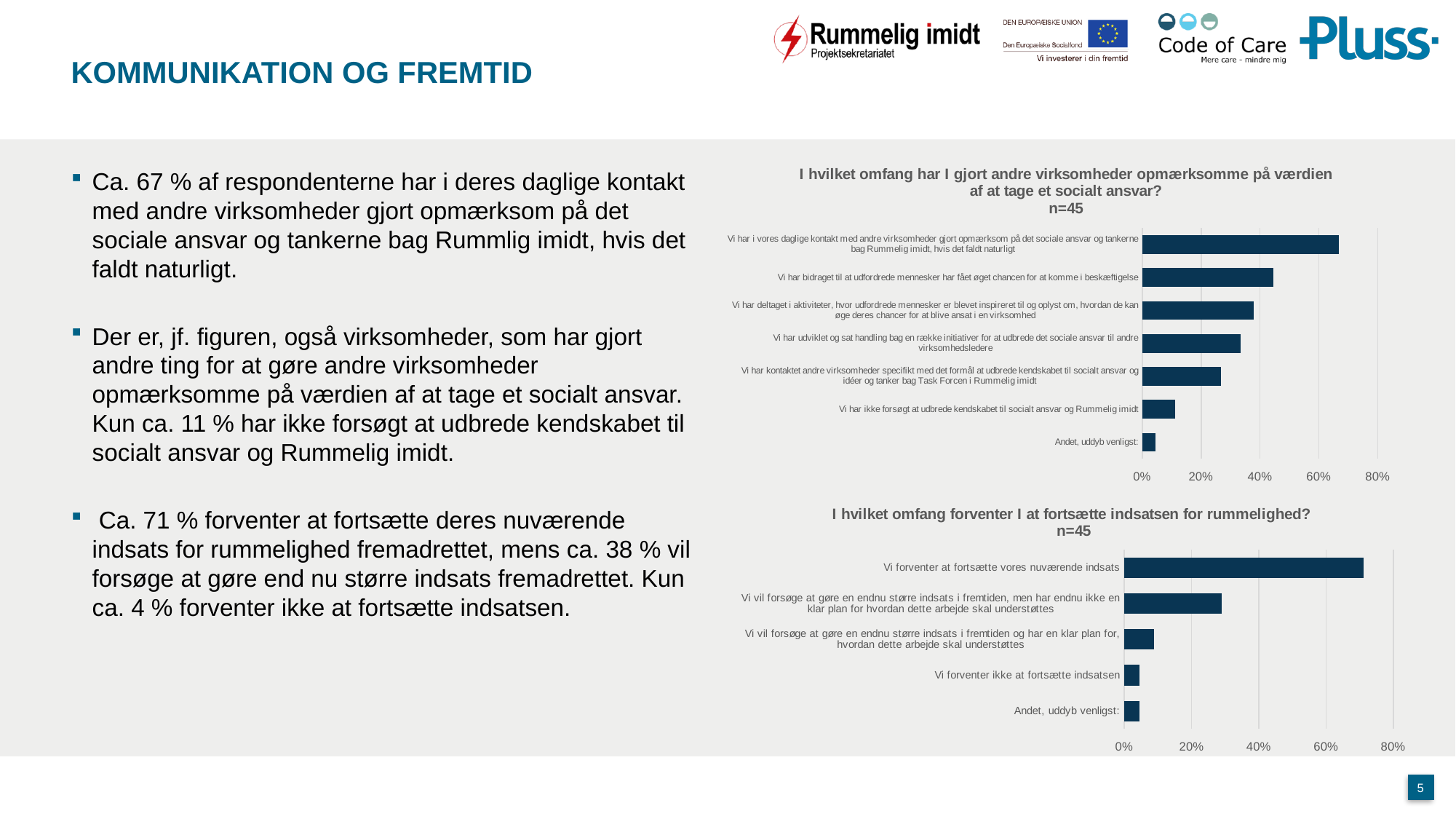
How many categories are shown in the top chart ("I hvilket omfang har I gjort andre virksomheder opmærksomme...")? 7 In the top chart, is the value for "Vi har ikke forsøgt at udbrede kendskabet til socialt ansvar og Rummelig imidt" greater or less than 20%? less In the top chart, which category has the highest value? Vi har i vores daglige kontakt med andre virksomheder gjort opmærksom på det sociale ansvar og tankerne bag Rummelig imidt, hvis det faldt naturligt In the bottom chart, which category has the highest value? Vi forventer at fortsætte vores nuværende indsats What sample size (n) is stated in the title of the bottom chart? n=45 What type of chart is the top chart titled "I hvilket omfang har I gjort andre virksomheder opmærksomme på værdien af at tage et socialt ansvar?"? bar chart In the bottom chart, is the value for "Vi vil forsøge at gøre en endnu større indsats i fremtiden, men har endnu ikke en klar plan for hvordan dette arbejde skal understøttes" greater or less than 40%? less In the bottom chart, which is larger: the value for "Vi vil forsøge at gøre en endnu større indsats i fremtiden, men har endnu ikke en klar plan..." or the value for "Vi vil forsøge at gøre en endnu større indsats i fremtiden og har en klar plan..."? Vi vil forsøge at gøre en endnu større indsats i fremtiden, men har endnu ikke en klar plan for hvordan dette arbejde skal understøttes How many categories are shown in the bottom chart ("I hvilket omfang forventer I at fortsætte indsatsen for rummelighed?")? 5 In the top chart, which category has the lowest value? Andet, uddyb venligst: In the bottom chart, is the value for "Vi forventer at fortsætte vores nuværende indsats" greater or less than 60%? greater